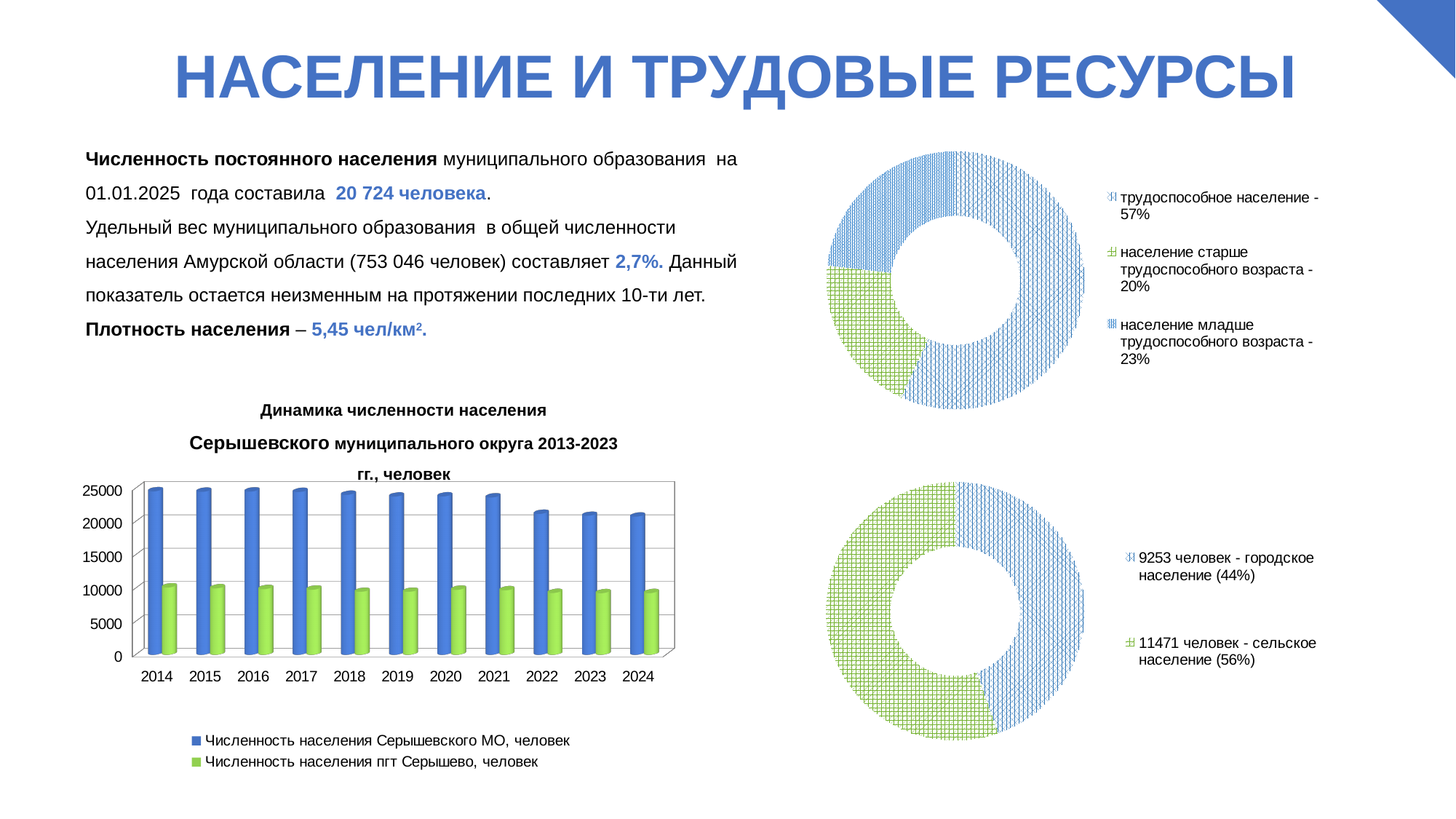
In the bar chart at the bottom left, is the value for 'Численность населения пгт Серышево, человек' in 2020 greater or less than 15000? less In the bar chart at the bottom left, which series has the larger value in 2018: 'Численность населения Серышевского МО' or 'Численность населения пгт Серышево'? Численность населения Серышевского МО In the bar chart at the bottom left, is the value for 'Численность населения Серышевского МО, человек' in 2014 greater or less than 20000? greater How many series does the legend of the bar chart at the bottom left list? 2 In the donut chart at the top right, what share is shown for 'трудоспособное население'? 57% How many years are shown on the x axis of the bar chart at the bottom left? 11 In the bar chart at the bottom left, do the values for 'Численность населения Серышевского МО, человек' rise or fall from 2014 to 2024? fall In the donut chart at the top right, which category has the smallest share? население старше трудоспособного возраста In the donut chart at the bottom right, what is the difference between 'сельское население' and 'городское население' in people? 2218 In the donut chart at the bottom right, how many people are in 'сельское население'? 11471 In the donut chart at the top right, what is the difference in percentage points between 'трудоспособное население' and 'население младше трудоспособного возраста'? 34 What type of chart is the chart titled 'Динамика численности населения Серышевского муниципального округа 2013-2023 гг., человек'? bar chart